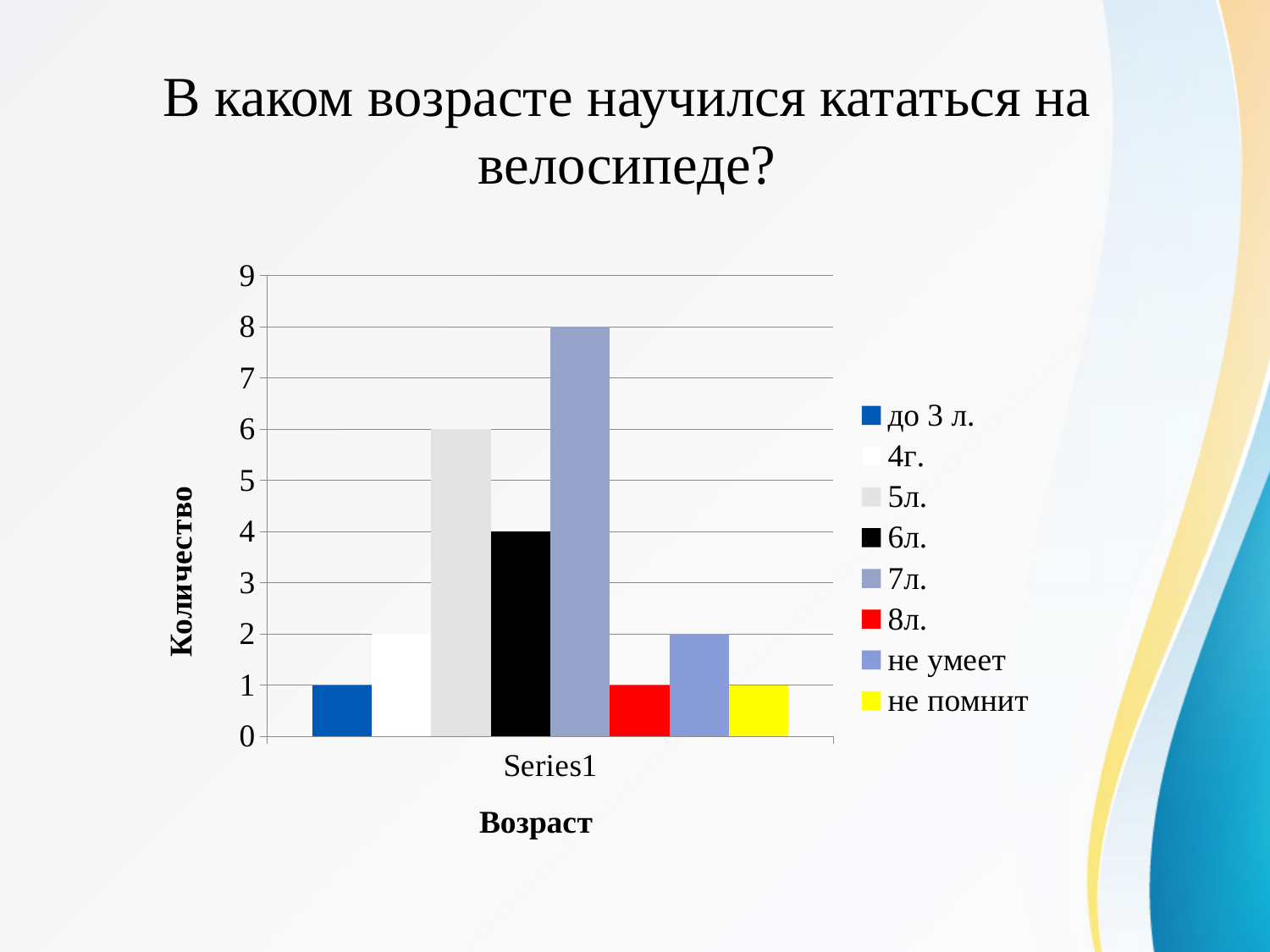
What is the difference between the values for 7л. and 5л.? 2 What is the value for 7л.? 8 What is the value for до 3 л.? 1 Is the value for 5л. greater or less than 5? greater What is the value for 5л.? 6 Which legend entry has the highest value? 7л. What kind of chart is shown on the slide? bar chart Which is larger, the value for 6л. or the value for 4г.? 6л. How many series does the legend list? 8 What is the title of the slide? В каком возрасте научился кататься на велосипеде? What is the label on the vertical axis? Количество What is the value for 6л.? 4